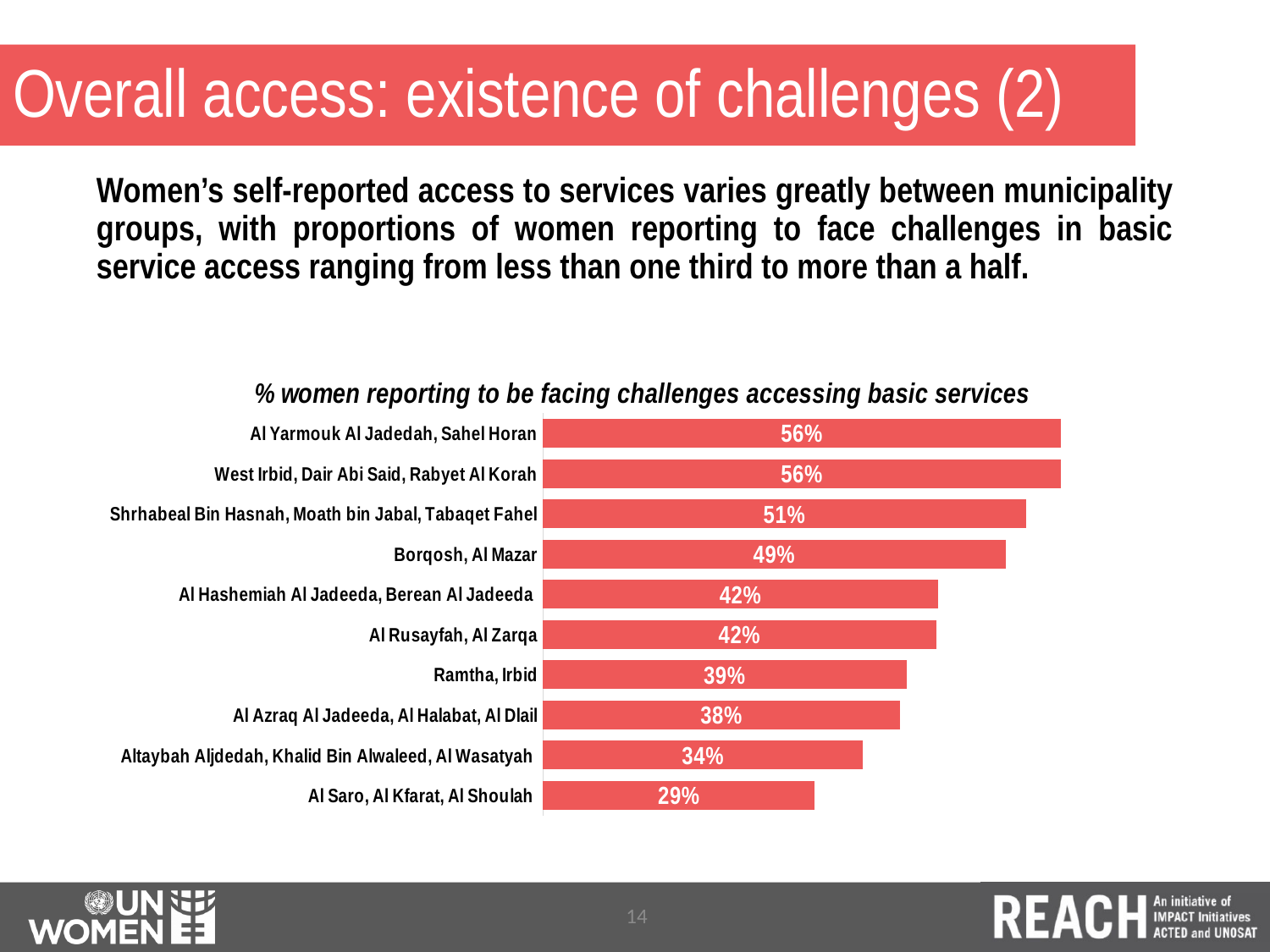
What is the difference between the values for Shrhabeal Bin Hasnah, Moath bin Jabal, Tabaqet Fahel and Al Azraq Al Jadeeda, Al Halabat, Al Dlail? 13% Which municipality group has the lowest proportion of women reporting challenges accessing basic services? Al Saro, Al Kfarat, Al Shoulah What is the difference between the highest and lowest values in the chart? 27% How many municipality groups are shown in the chart? 10 What is the highest value shown in the chart? 56% What kind of chart is shown on the slide? Bar chart What percentage of women in Borqosh, Al Mazar report facing challenges accessing basic services? 49% What is the value shown for Al Saro, Al Kfarat, Al Shoulah? 29% Which is larger: the value for Borqosh, Al Mazar or the value for Al Rusayfah, Al Zarqa? Borqosh, Al Mazar What is the value shown for Altaybah Aljdedah, Khalid Bin Alwaleed, Al Wasatyah? 34% What is the value shown for Ramtha, Irbid? 39% What is the title of the chart? % women reporting to be facing challenges accessing basic services